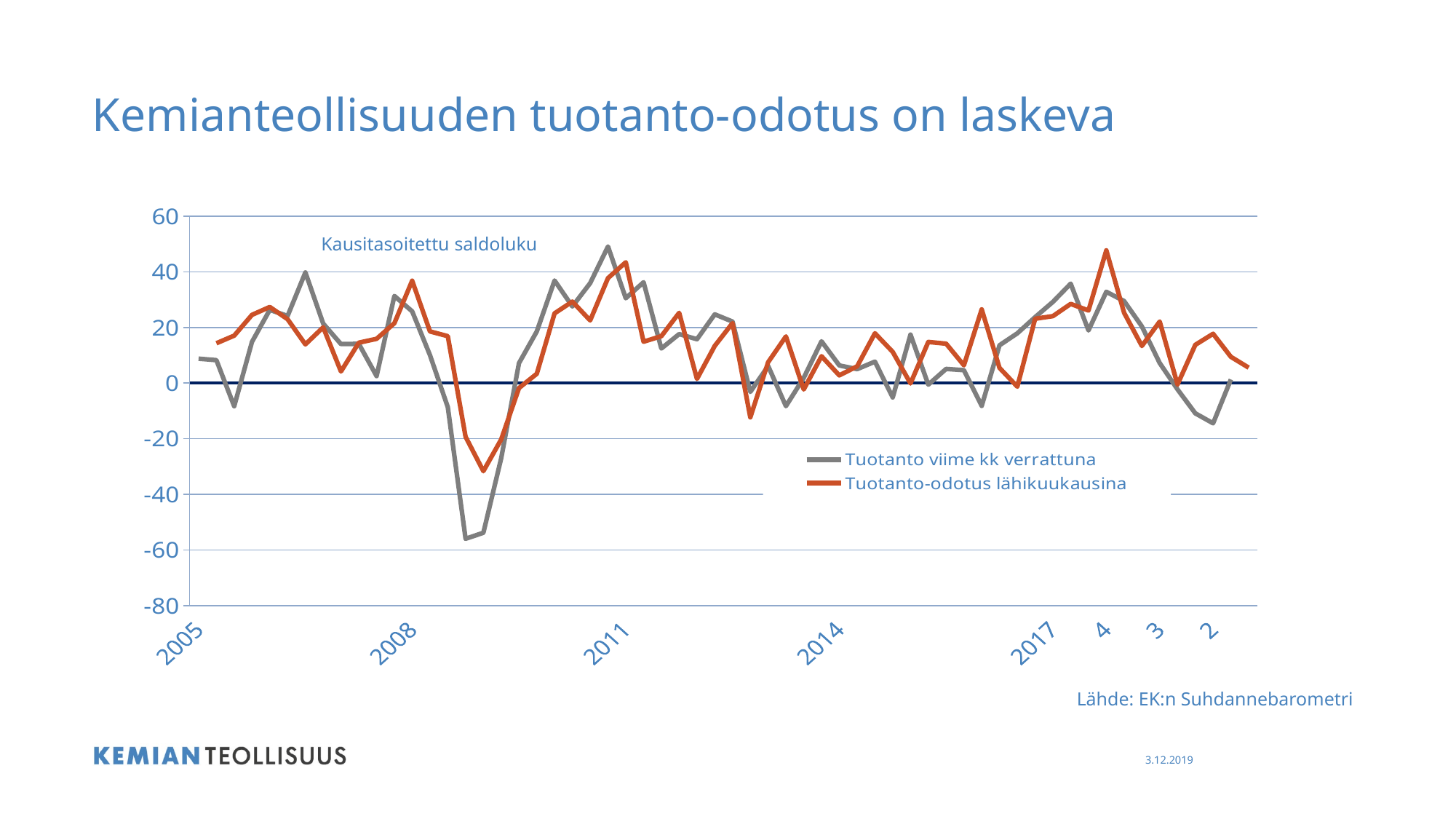
Is the peak of the 'Tuotanto-odotus lähikuukausina' series around 2018 greater or less than 40? greater Is the final value of the 'Tuotanto-odotus lähikuukausina' series at the right end of the chart greater or less than 20? less Is the lowest value of the 'Tuotanto viime kk verrattuna' series (around 2009) greater or less than -40? less Does the 'Tuotanto-odotus lähikuukausina' series rise or fall from its 2018 peak to the right end of the chart? fall What is the title of the slide's chart? Kemianteollisuuden tuotanto-odotus on laskeva What is the lowest value shown on the vertical axis? -80 How many series does the legend list? 2 Which series is drawn in orange according to the legend? Tuotanto-odotus lähikuukausina Which series drops to a lower minimum around 2009, 'Tuotanto viime kk verrattuna' or 'Tuotanto-odotus lähikuukausina'? Tuotanto viime kk verrattuna What kind of chart is shown on the slide? line chart